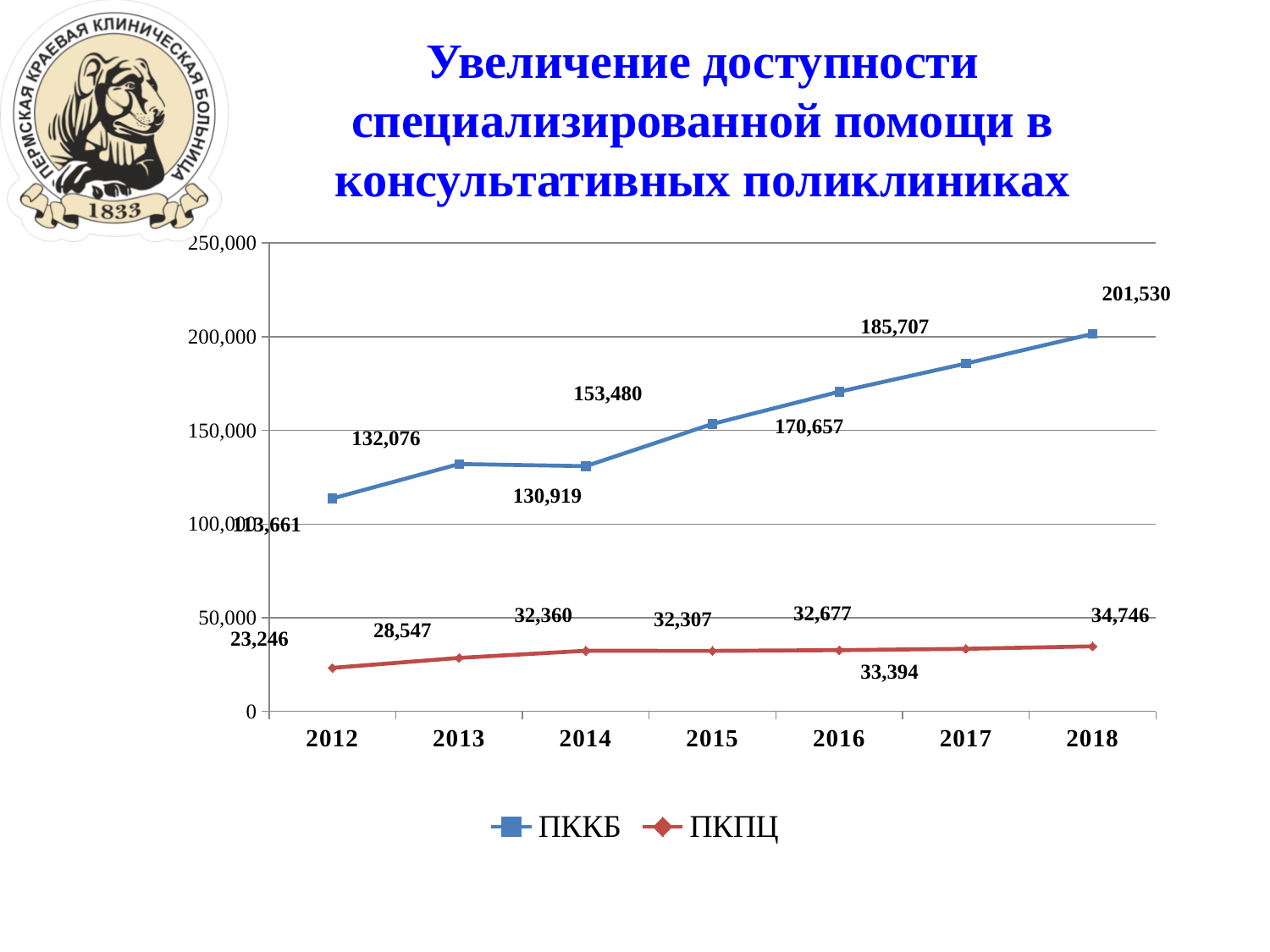
Is the value for ПККБ in 2015 greater or less than 150,000? greater What is the difference between the ПККБ values for 2018 and 2017? 15,823 What is the value for ПККБ in 2018? 201,530 What type of chart is shown on the slide? line chart What is the value for ПККБ in 2016? 170,657 Which is larger, the ПККБ value in 2013 or in 2014? 2013 In which year is the ПКПЦ value lowest? 2012 Does the ПККБ series generally rise or fall from 2014 to 2018? rise What is the value for ПКПЦ in 2013? 28,547 How many years are shown on the x axis? 7 How many series does the legend list? 2 In which year is the ПККБ value highest? 2018